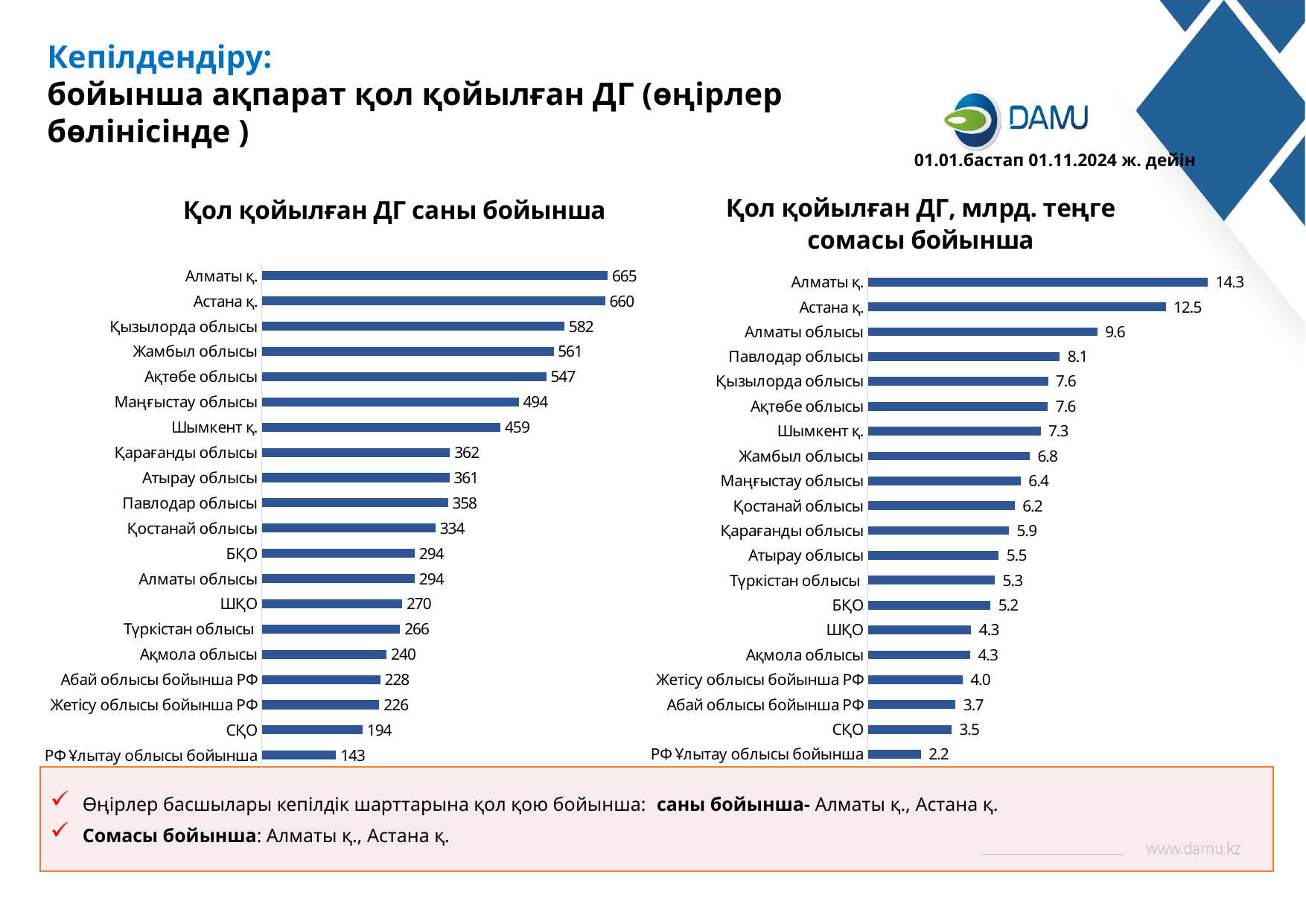
In the right chart ("Қол қойылған ДГ, млрд. теңге сомасы бойынша"), what is the difference between the values for Алматы қ. and Астана қ.? 1.8 What kind of chart is the right chart ("Қол қойылған ДГ, млрд. теңге сомасы бойынша")? Bar chart In the left chart ("Қол қойылған ДГ саны бойынша"), which category has the highest value? Алматы қ. In the chart titled "Қол қойылған ДГ, млрд. теңге сомасы бойынша", what is the value for Павлодар облысы? 8.1 In the left chart ("Қол қойылған ДГ саны бойынша"), what is the difference between the values for Алматы қ. and Астана қ.? 5 In the chart titled "Қол қойылған ДГ саны бойынша", what is the value for Қызылорда облысы? 582 What is the date range shown on the slide for the data? 01.01.бастап 01.11.2024 ж. дейін How many categories are shown in the left chart ("Қол қойылған ДГ саны бойынша")? 20 In the left chart ("Қол қойылған ДГ саны бойынша"), which is larger: the value for Шымкент қ. or the value for Қарағанды облысы? Шымкент қ. In the right chart ("Қол қойылған ДГ, млрд. теңге сомасы бойынша"), which category has the lowest value? РФ Ұлытау облысы бойынша In the left chart ("Қол қойылған ДГ саны бойынша"), what is the value for СҚО? 194 In the right chart ("Қол қойылған ДГ, млрд. теңге сомасы бойынша"), which is larger: the value for Алматы облысы or the value for Жамбыл облысы? Алматы облысы